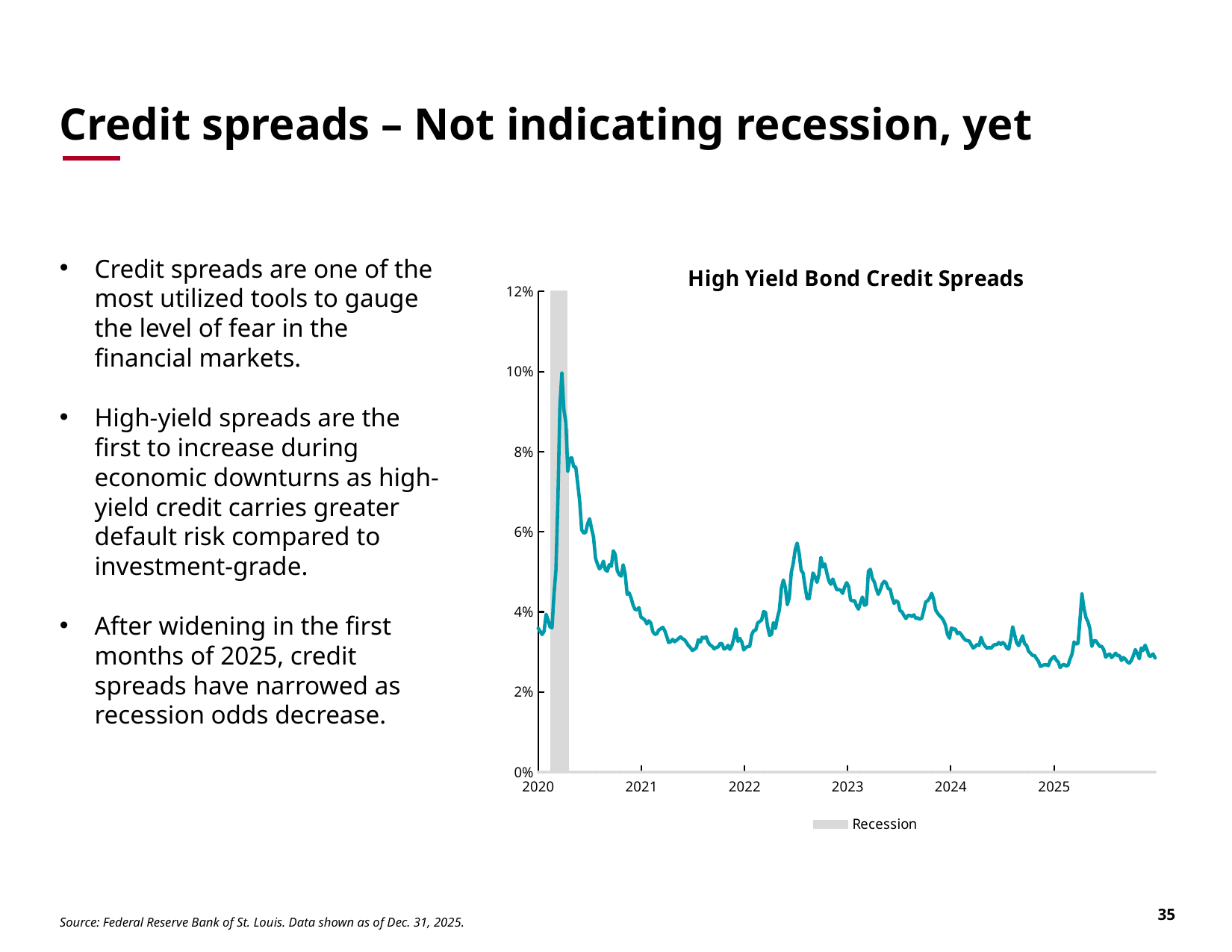
Is the peak of the line in mid-2022 greater or less than 4%? greater What is the only entry listed in the chart's legend? Recession Is the spike in the line in 2025 higher or lower than the peak in 2022? lower Is the value of the line at the end of 2025 greater or less than 4%? less Is the peak value of the line in 2020 greater or less than 8%? greater What is the title of the chart? High Yield Bond Credit Spreads From its peak in 2020 to the end of 2021, does the line rise or fall? fall Which is higher, the peak of the line in 2020 or the peak in 2022? 2020 In which year does the line reach its highest value? 2020 What kind of chart is shown on the slide? line chart